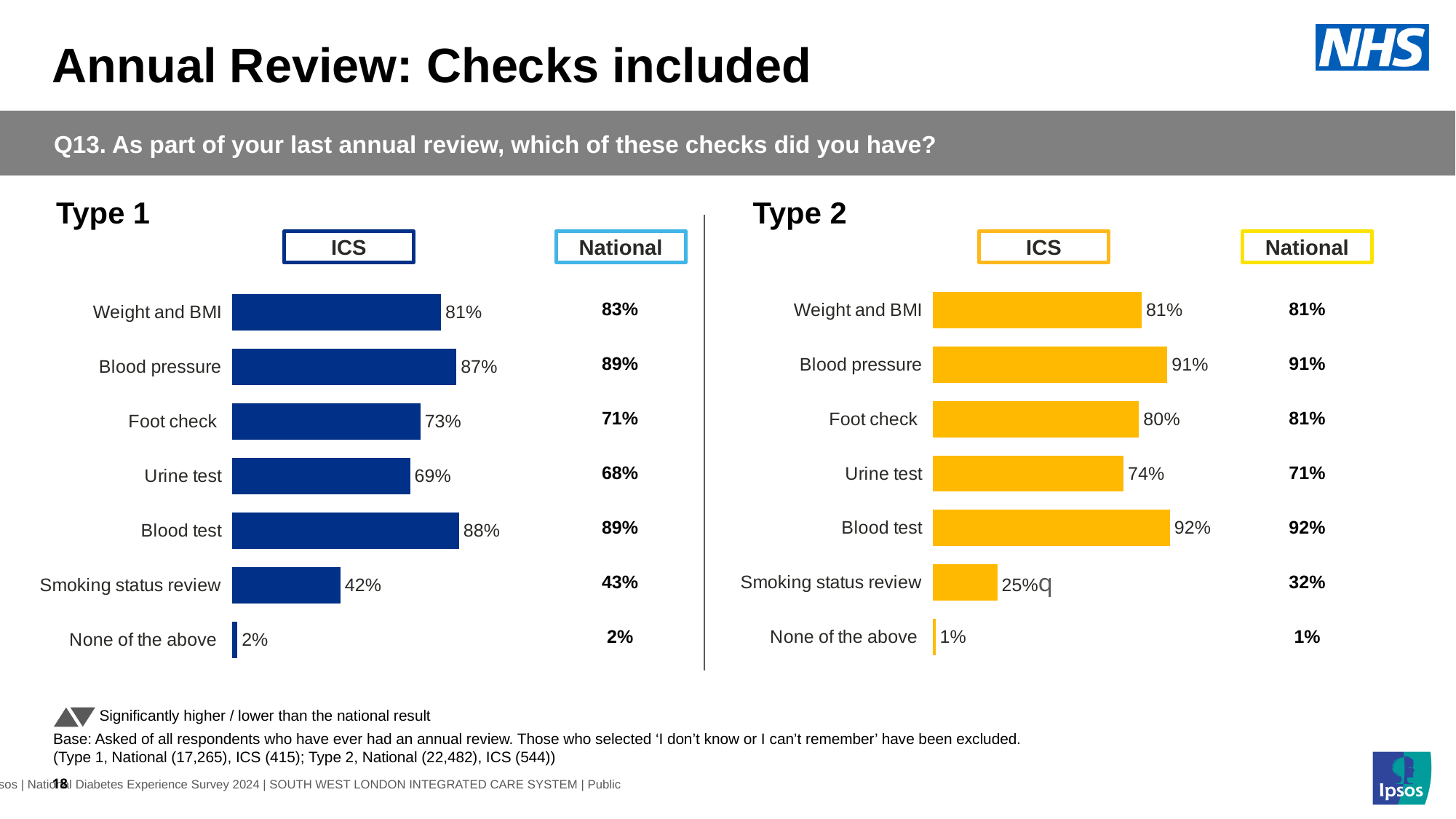
What colour are the bars in the Type 2 chart? yellow In the Type 1 chart, is the ICS value for Foot check higher or lower than the ICS value for Urine test? higher In the Type 2 chart, what is the ICS value for Urine test? 74% In the Type 1 chart, what is the National value for Foot check? 71% In the Type 1 chart, what is the ICS value for Blood pressure? 87% In the Type 2 chart, what is the National value for Smoking status review? 32% In the Type 2 chart, what is the difference between the ICS and National values for Smoking status review? 7% In the Type 1 chart, what is the difference between the ICS values for Blood test and Urine test? 19% What type of chart is used for the Type 1 ICS results? bar chart In the Type 1 chart, which check has the highest ICS value? Blood test In the Type 2 chart, which check has the lowest ICS value? None of the above How many checks are listed in the Type 2 chart? 7